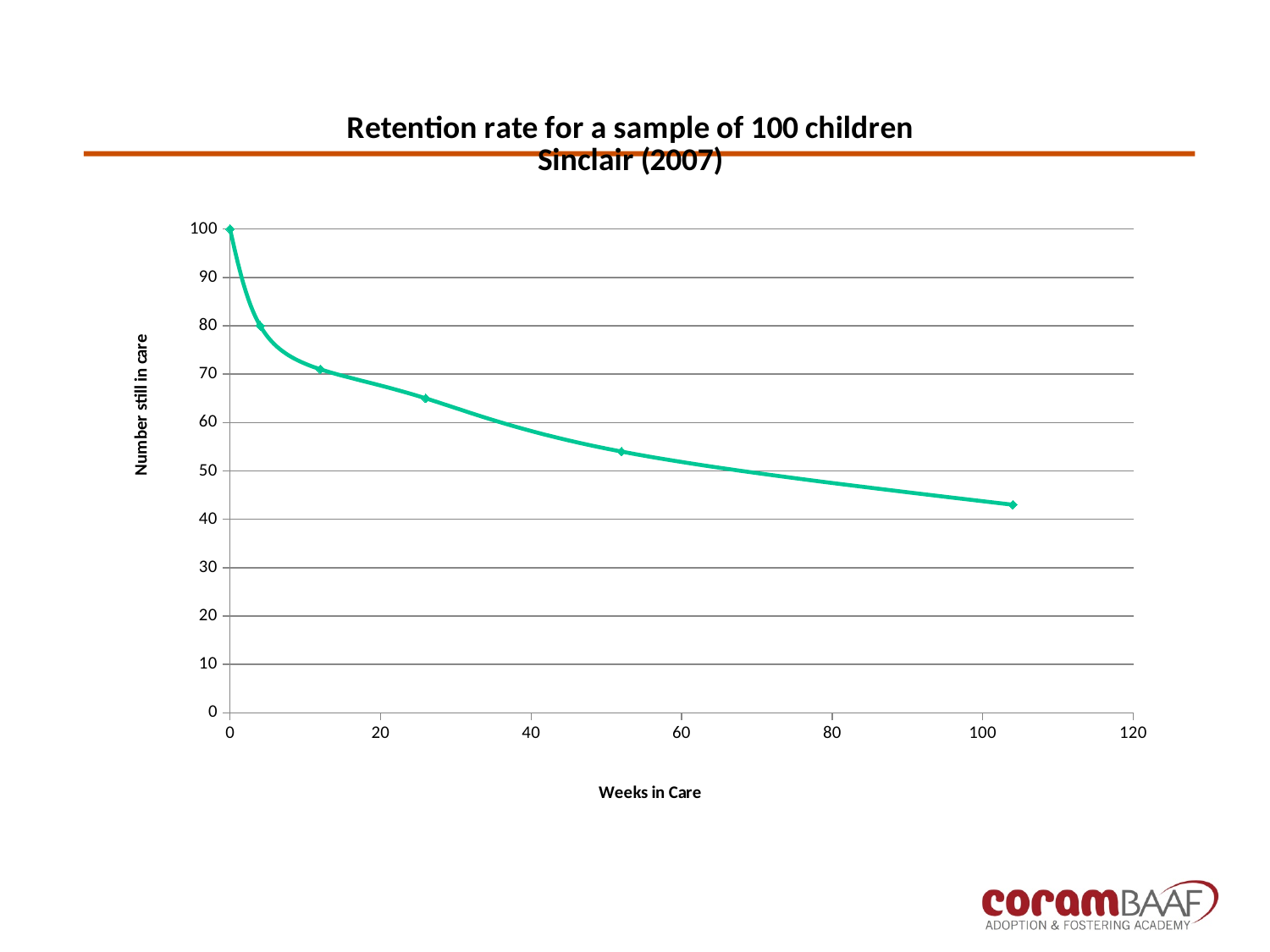
Is the value of the second point from the left greater or less than 70? greater Which point has the highest number still in care? the point at 0 weeks Is the value of the fourth point from the left greater or less than 60? greater Do the values rise or fall as weeks in care increase? fall How many data points are plotted on the line? 6 What is the label of the horizontal axis? Weeks in Care What is the number still in care at 0 weeks? 100 What is the label of the vertical axis? Number still in care Which is larger: the value at the first point or the value at the last point? the first point Is the value of the rightmost (final) point greater or less than 50? less What kind of chart is shown on the slide? line chart